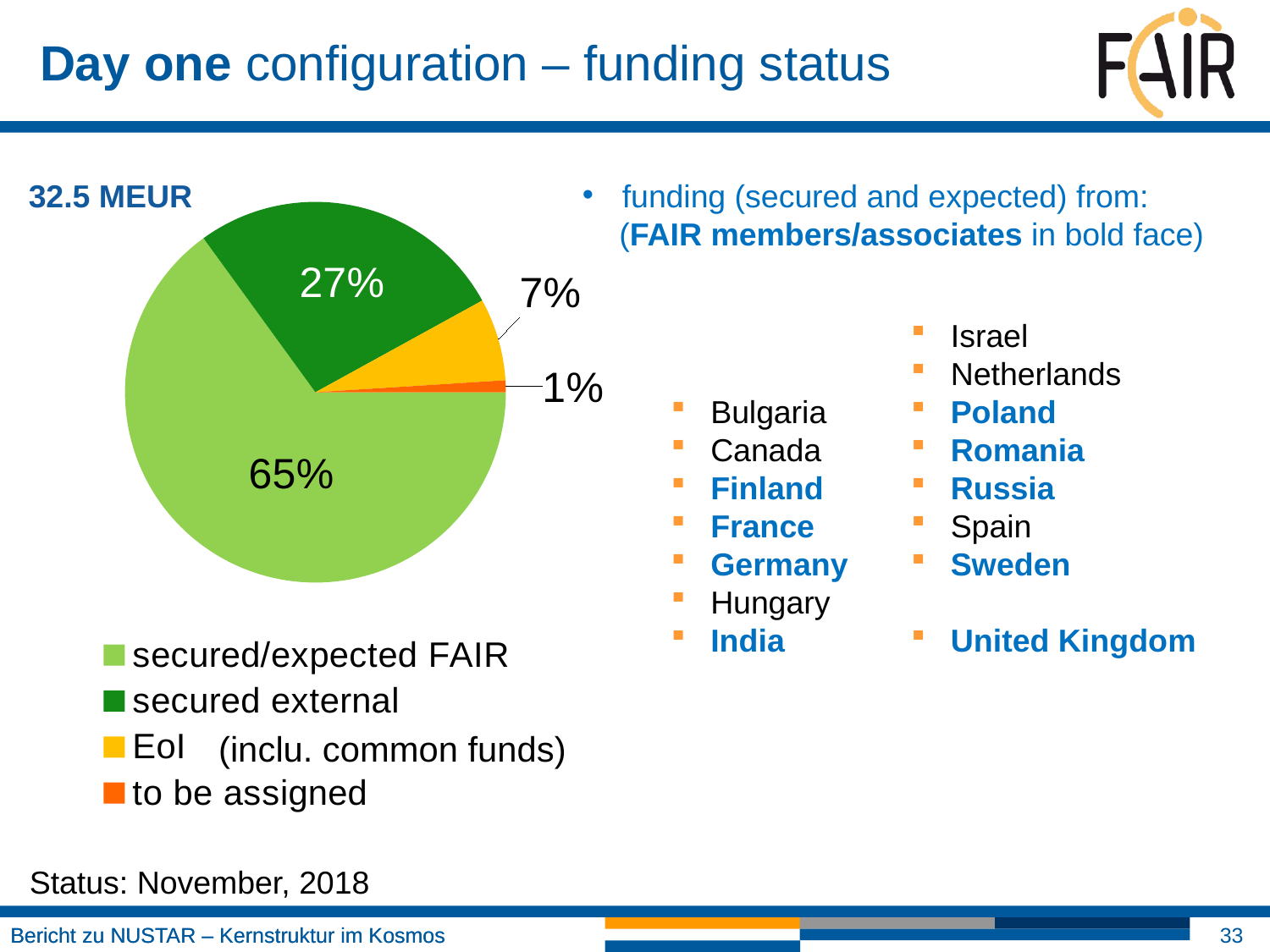
What share of the pie is labelled to be assigned? 1% What share of the pie is labelled secured/expected FAIR? 65% Which category has the largest slice of the pie? secured/expected FAIR What share of the pie is labelled EoI? 7% How many slices does the pie chart have? 4 Which category has the smallest slice of the pie? to be assigned What total amount is stated above the pie chart? 32.5 MEUR Which legend entry is shown in dark green? secured external What kind of chart is shown on the slide? pie chart What is the difference in percentage points between the secured/expected FAIR slice and the secured external slice? 38 Which is larger, the EoI slice or the secured external slice? secured external